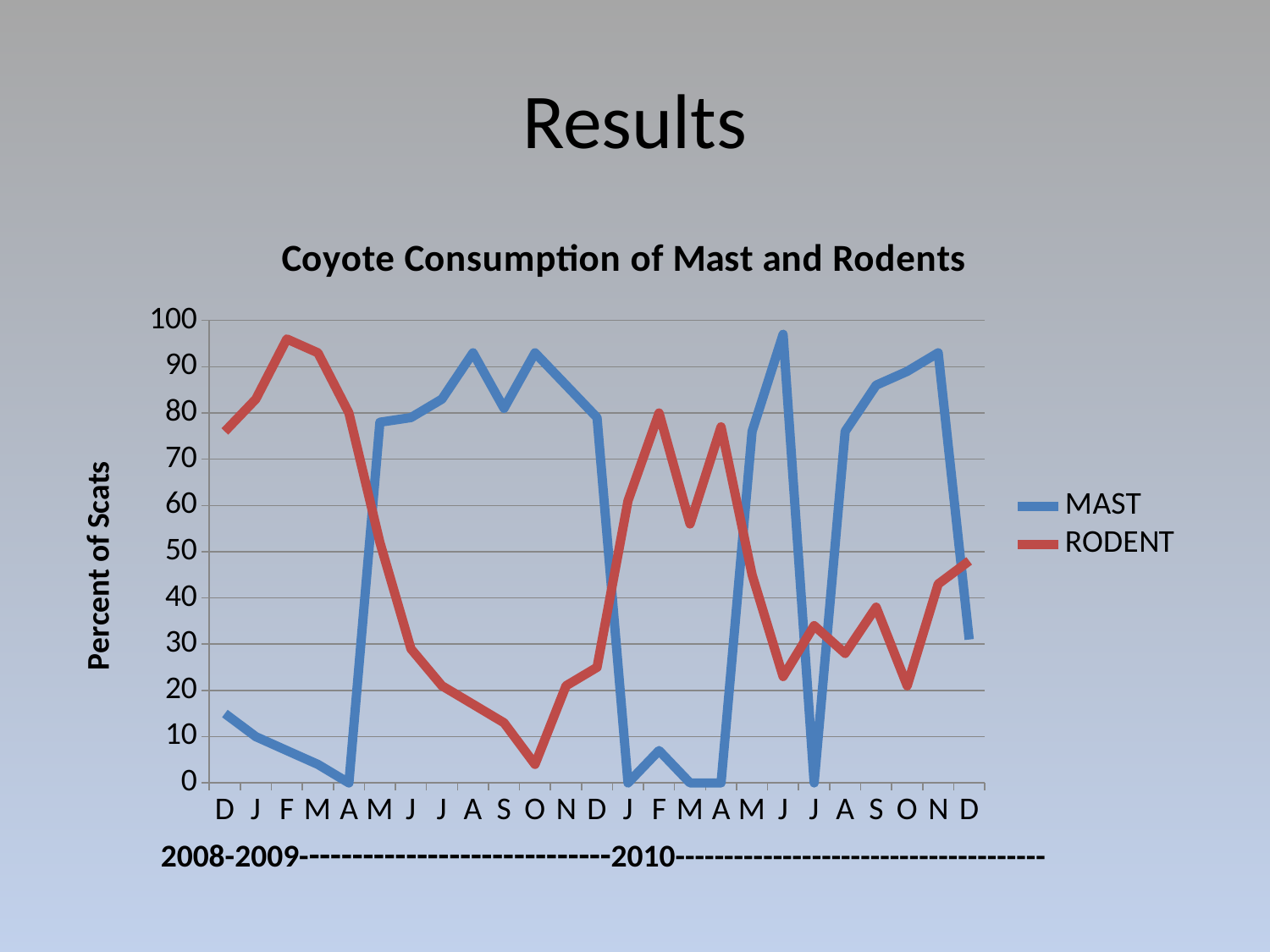
At the first F (February 2009), which series has the larger value, MAST or RODENT? RODENT At the first A after J J (August 2009), which series has the larger value, MAST or RODENT? MAST How many month points are plotted along the x axis? 25 How many series does the legend list? 2 Is the MAST value at the first D (December 2008) greater or less than 20? less What kind of chart is shown on the slide? line chart Is the RODENT value at the first D (December 2008) greater or less than 70? greater Is the RODENT value at the first F (February 2009) greater or less than 90? greater What is the label on the vertical axis? Percent of Scats What is the title of the chart? Coyote Consumption of Mast and Rodents Does the MAST line rise or fall from the first D (December 2008) to the first A (April 2009)? fall